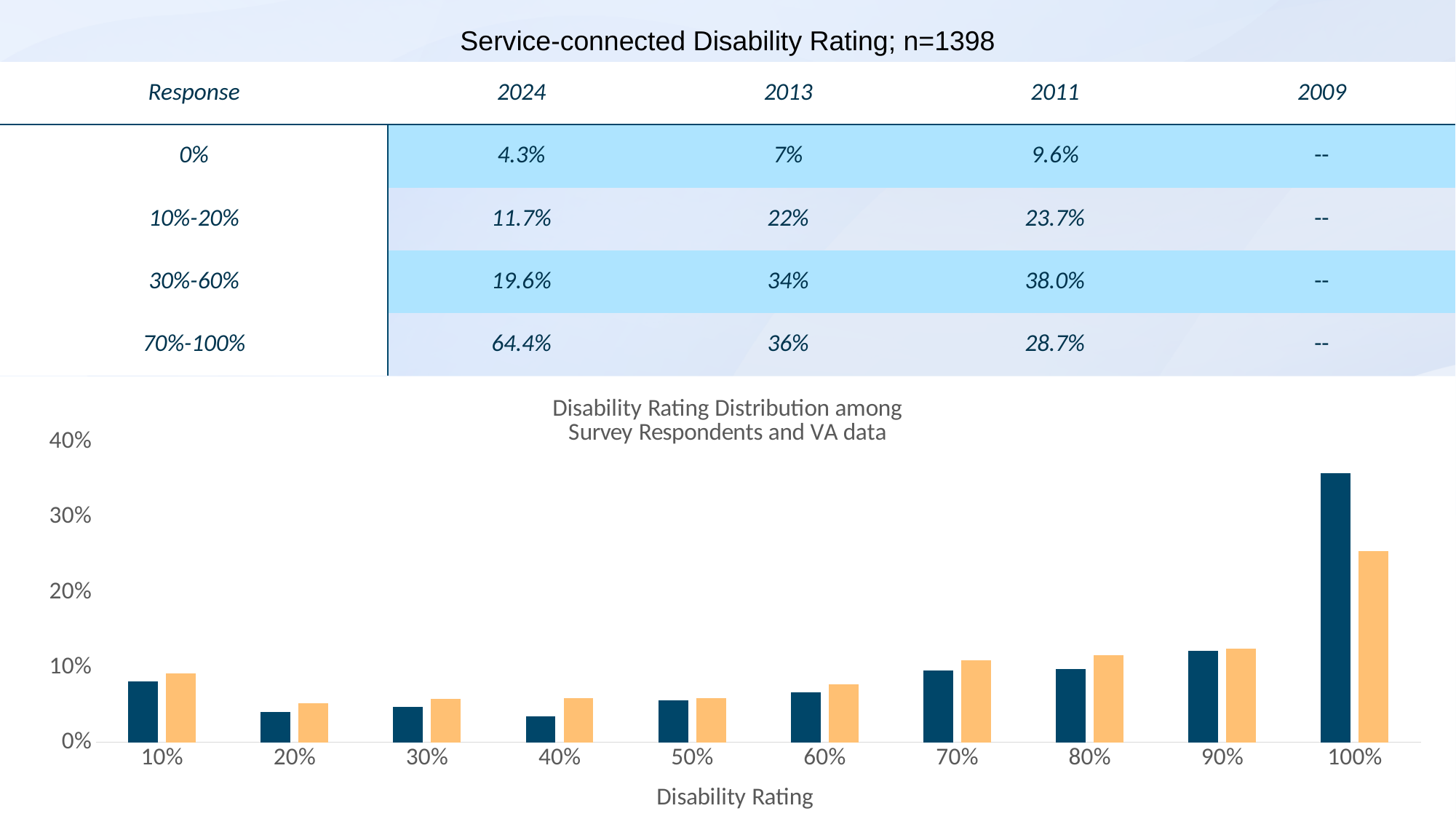
Is the dark blue bar for the 100% disability rating greater or less than 30%? greater Which disability rating category has the lowest dark blue bar in the chart? 40% Which disability rating category has the lowest orange bar in the chart? 20% Is the orange bar for the 100% disability rating greater or less than 20%? greater How many disability rating categories are shown on the x axis of the chart? 10 What kind of chart is shown on the slide? bar chart Is the dark blue bar for the 20% disability rating greater or less than 10%? less Do the dark blue bars rise or fall from the 60% category to the 100% category? rise At the 100% disability rating, which bar is taller, the dark blue or the orange? dark blue Which disability rating category has the highest dark blue bar in the chart? 100% What is the x-axis title of the chart? Disability Rating What is the title of the chart? Disability Rating Distribution among Survey Respondents and VA data